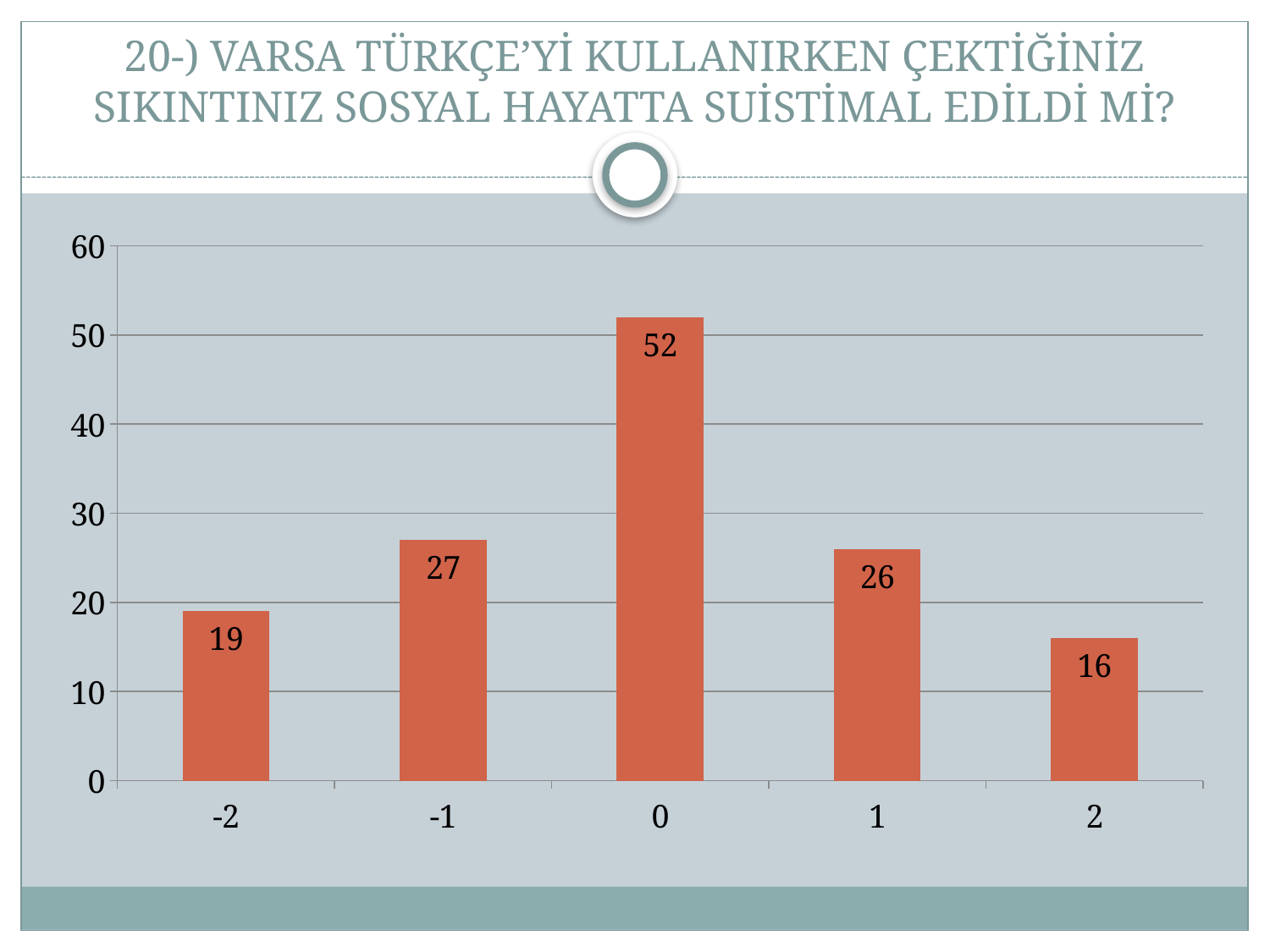
Which is larger, the value for -1 or the value for 1? -1 What is the difference between the values for -2 and 2? 3 What kind of chart is shown on the slide? bar chart What is the value for category 2? 16 What is the value for category 0? 52 What is the difference between the values for 0 and -1? 25 What colour are the bars in the chart? orange-red How many categories are shown on the x axis? 5 Which category has the lowest value? 2 Is the value for 0 greater or less than 50? greater What is the value for category -2? 19 Which category has the highest value? 0